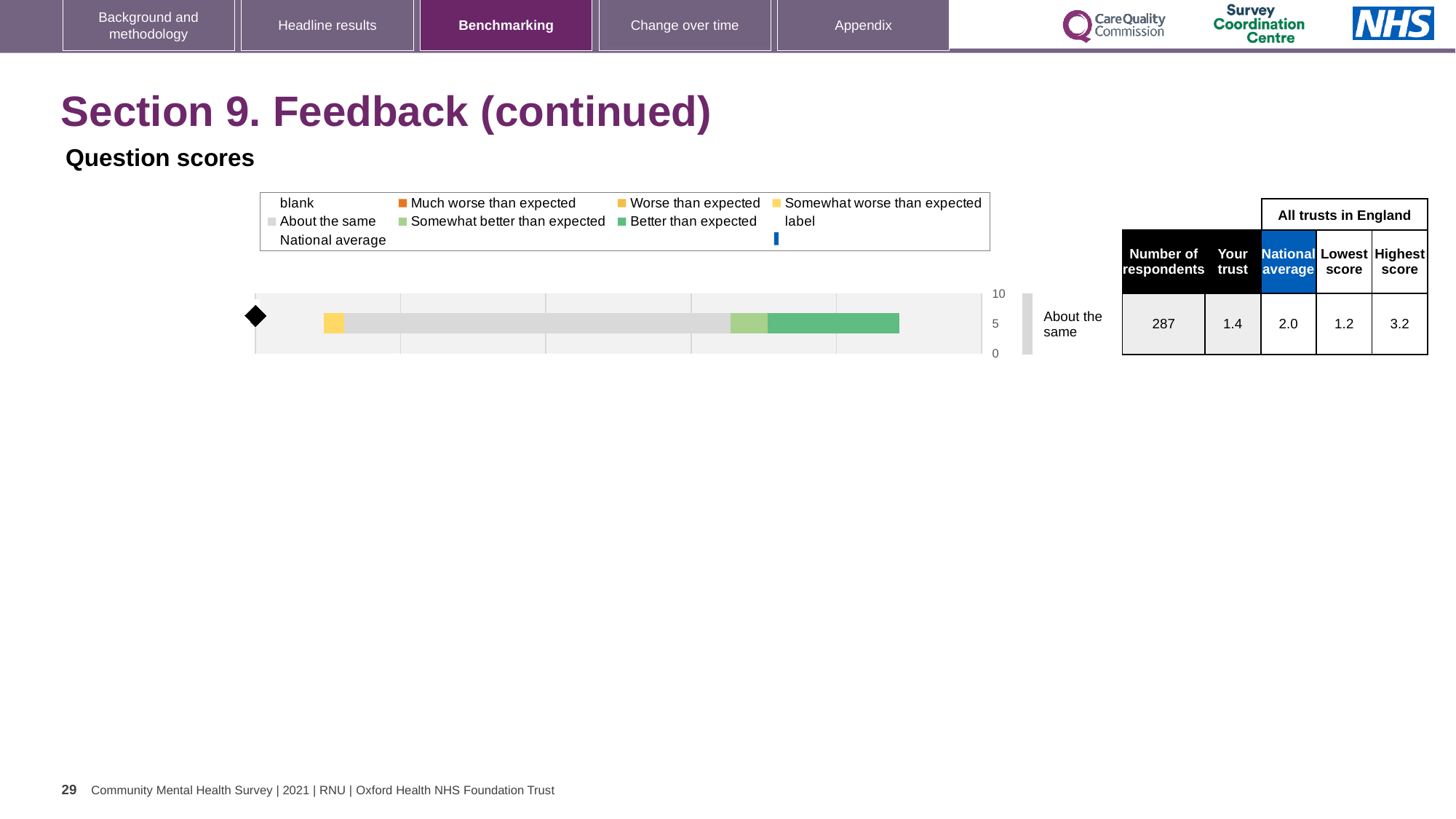
What is the national average score for the question 'About the same'? 2.0 What is the difference between the highest score (3.2) and the lowest score (1.2) for 'About the same'? 2.0 How many question categories are plotted in the chart? 1 Which is larger for 'About the same': the trust's score or the national average? national average What is the highest score among all trusts in England for 'About the same'? 3.2 What kind of chart is shown on the slide? bar chart How many respondents answered the question 'About the same'? 287 What is the label of the question plotted in the chart? About the same What is the lowest score among all trusts in England for 'About the same'? 1.2 Which legend entry is shown in grey? About the same What is the difference between the national average (2.0) and the trust's score (1.4) for 'About the same'? 0.6 What is the 'Your trust' score for the question 'About the same'? 1.4